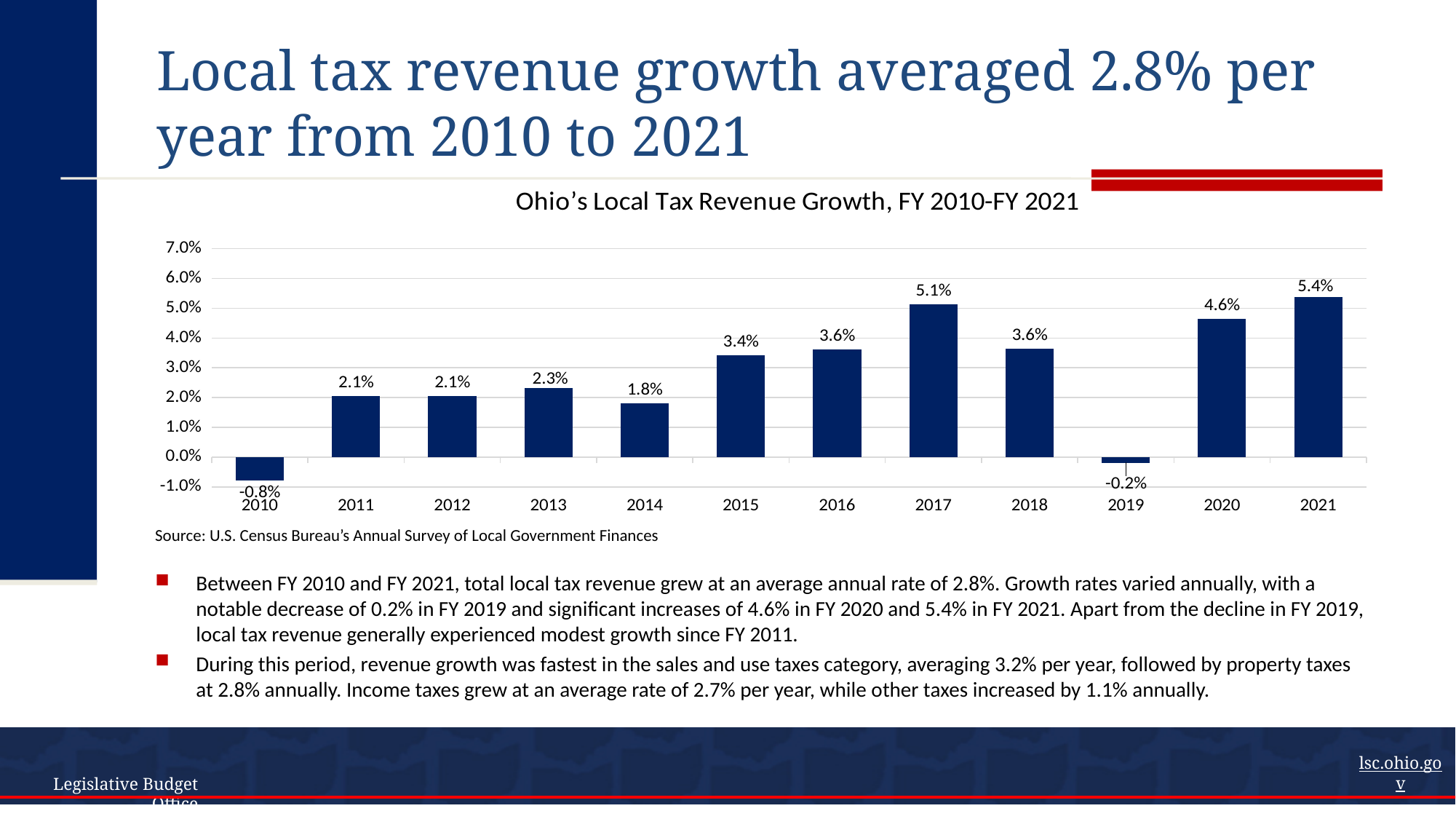
What was Ohio's local tax revenue growth in FY 2017? 5.1% What is the difference between the growth rates in 2021 and 2020? 0.8% Which year had the lowest local tax revenue growth? 2010 What was the local tax revenue growth value for 2010? -0.8% What was the local tax revenue growth in 2019? -0.2% What is the title of the chart? Ohio's Local Tax Revenue Growth, FY 2010-FY 2021 Which year had higher growth, 2015 or 2016? 2016 What kind of chart is shown on the slide? Bar chart Did local tax revenue growth rise or fall from 2018 to 2019? Fall Is the value for 2014 greater or less than 2.0%? less Which year had the highest local tax revenue growth? 2021 How many years are shown on the x axis of the chart? 12